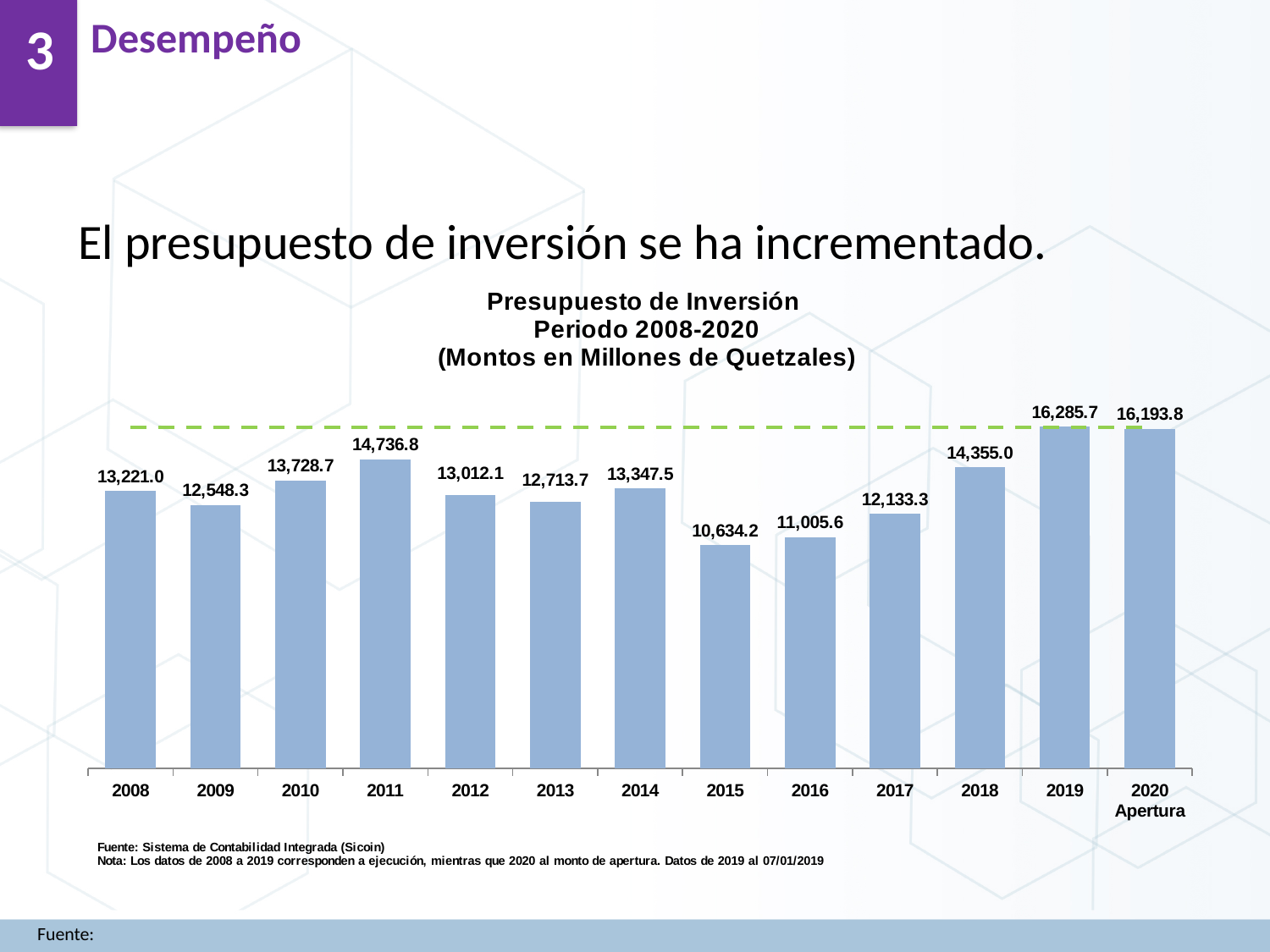
How many bars are plotted in the chart? 13 What kind of chart is shown on the slide? Bar chart Which year has the highest value in the chart? 2019 In what units are the amounts in the chart expressed, according to its title? Millones de Quetzales Which year has the lowest value in the chart? 2015 What is the difference between the values for 2016 and 2015? 371.4 What is the value for 2011 in the Presupuesto de Inversión chart? 14,736.8 What is the value for 2015 in the Presupuesto de Inversión chart? 10,634.2 What is the difference between the values for 2019 and 2018? 1,930.7 Do the values rise or fall from 2015 to 2019? Rise What is the value shown for 2020 Apertura? 16,193.8 Which is larger, the value for 2010 or the value for 2012? 2010